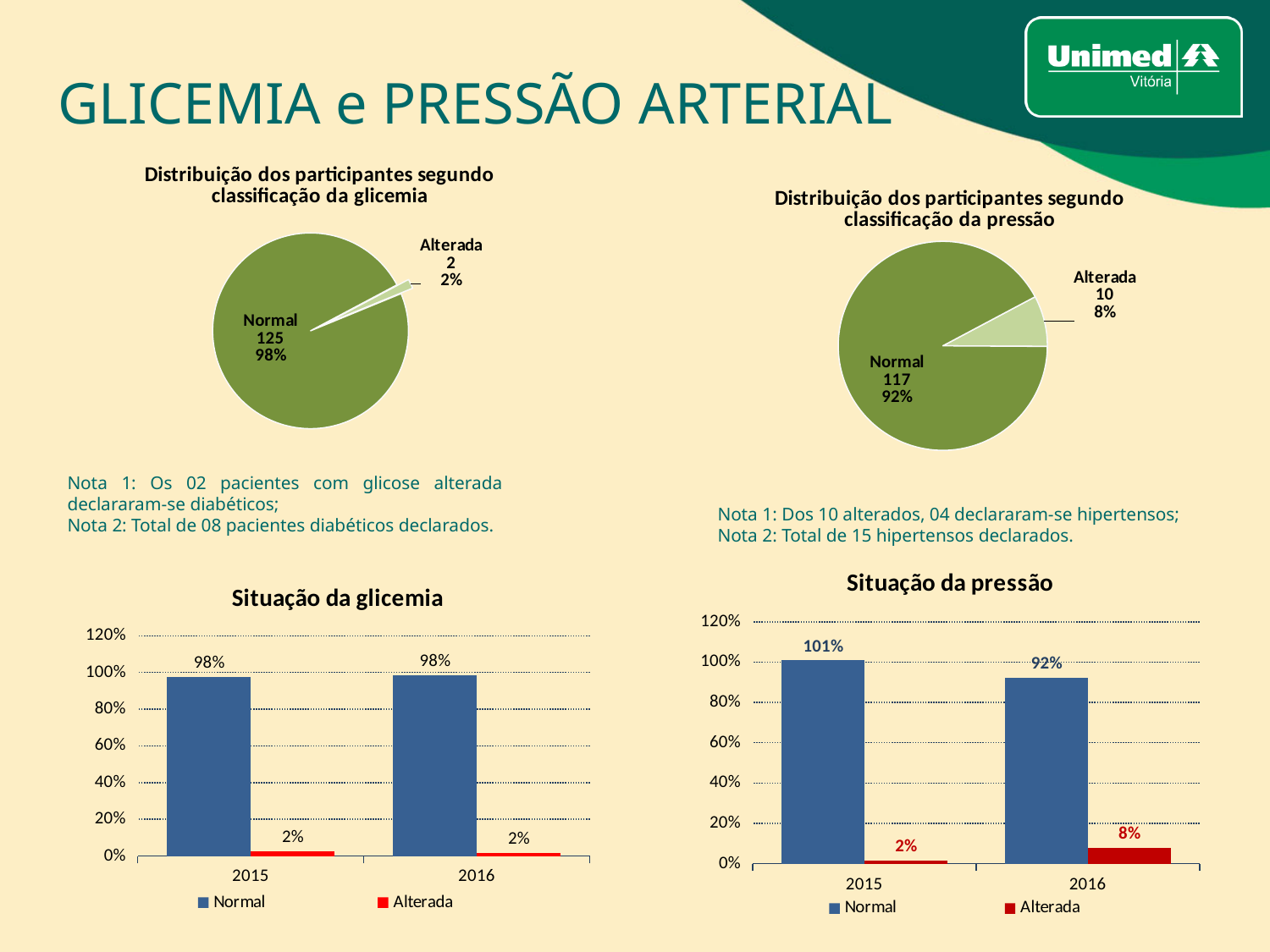
In the pie chart 'Distribuição dos participantes segundo classificação da glicemia', how many participants are classified as Normal? 125 In the chart 'Situação da glicemia', what is the Alterada value for 2015? 2% In the chart 'Situação da glicemia', what is the Normal value for 2016? 98% In the pie chart 'Distribuição dos participantes segundo classificação da pressão', how many participants are classified as Alterada? 10 How many series does the legend of the chart 'Situação da glicemia' list? 2 In the pie chart 'Distribuição dos participantes segundo classificação da pressão', what share of participants is Normal? 92% In the pie chart 'Distribuição dos participantes segundo classificação da glicemia', what share of participants is Alterada? 2% In the chart 'Situação da pressão', what is the Alterada value for 2016? 8% In the chart 'Situação da pressão', does the Normal value rise or fall from 2015 to 2016? fall In the chart 'Situação da pressão', what is the Normal value for 2015? 101% In the chart 'Situação da pressão', by how much did the Alterada value change from 2015 to 2016? 6% In the pie chart 'Distribuição dos participantes segundo classificação da pressão', what is the difference in participant count between Normal and Alterada? 107